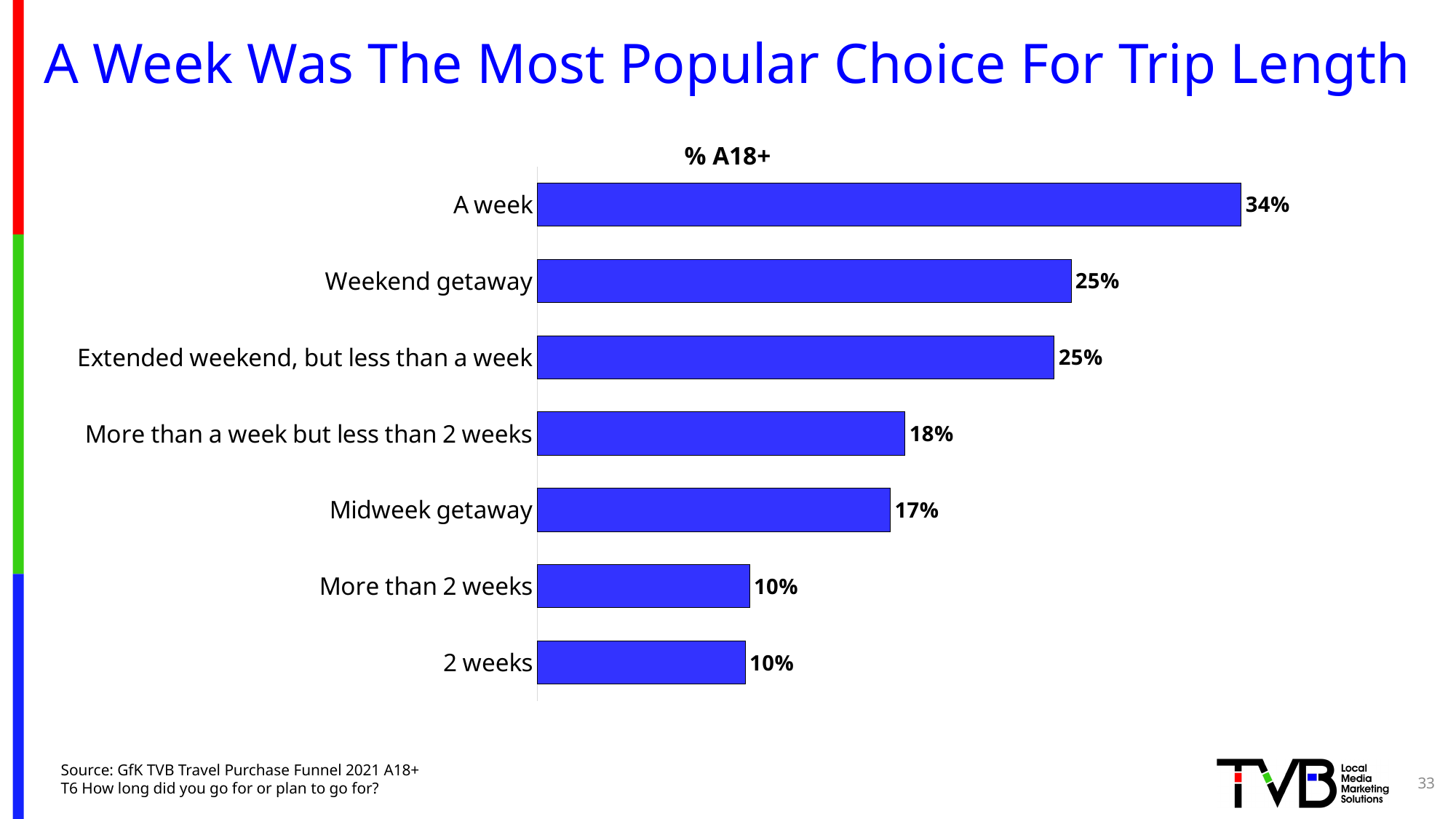
How many trip length categories are shown in the chart? 7 What is the value for "Midweek getaway"? 17% What is the difference between the values for "A week" and "Weekend getaway"? 9% What is the value for "More than a week but less than 2 weeks"? 18% What is the value for "2 weeks"? 10% Which is larger, the value for "Weekend getaway" or the value for "Midweek getaway"? Weekend getaway What is the difference between "Extended weekend, but less than a week" and "More than 2 weeks"? 15% What percentage of A18+ chose "A week" as their trip length? 34% What colour are the bars in the chart? Blue What is the title shown above the chart? % A18+ Which trip length has the highest percentage? A week What kind of chart is shown on the slide? Bar chart